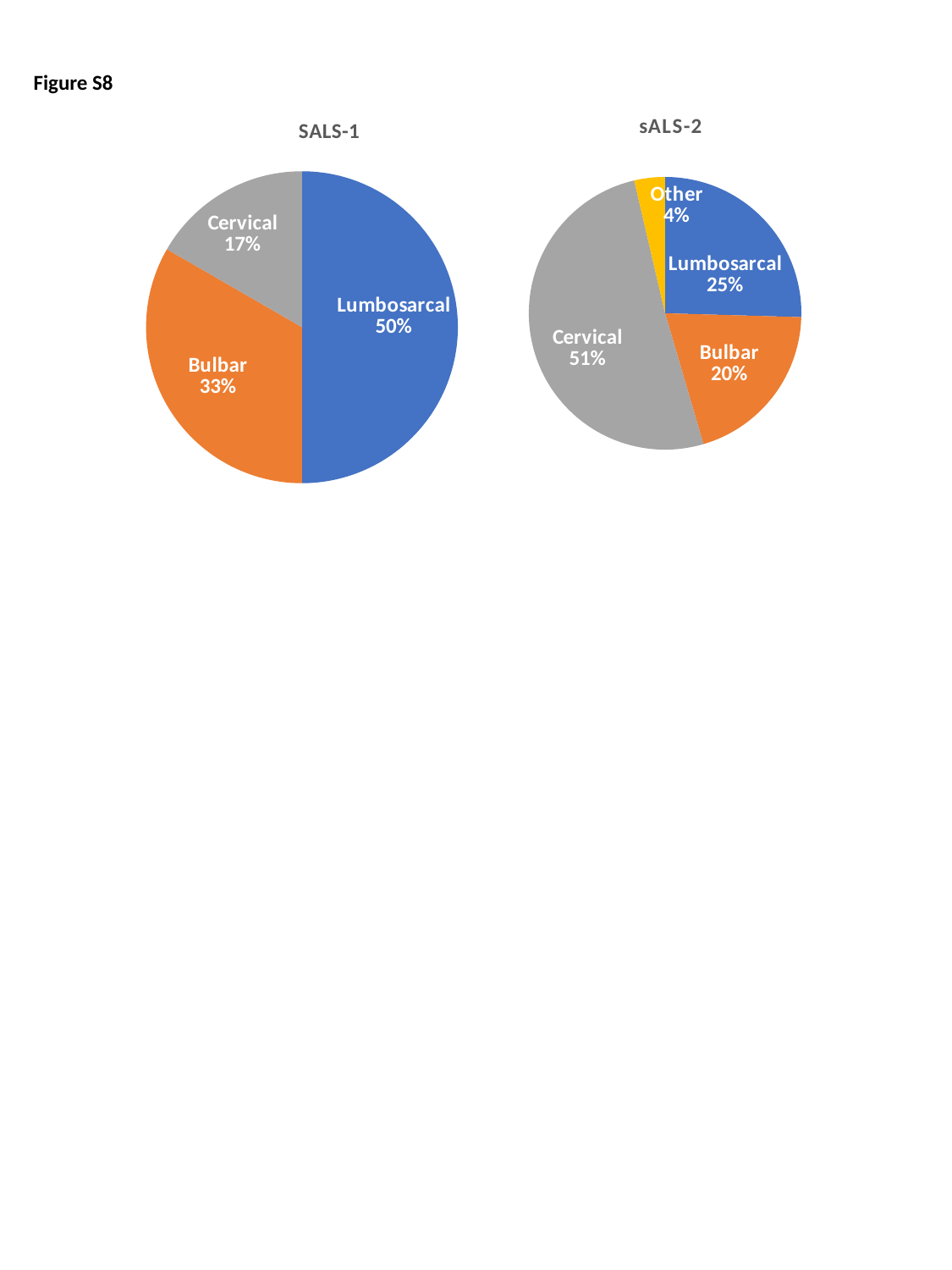
In the sALS-2 chart, which is larger, Lumbosarcal or Bulbar? Lumbosarcal In the SALS-1 chart, what percentage is shown for Bulbar? 33% How many slices does the SALS-1 chart have? 3 What type of chart is the SALS-1 chart? Pie chart In the SALS-1 chart, what is the difference in percentage points between Bulbar and Cervical? 16 In the sALS-2 chart, what is the difference in percentage points between Cervical and Lumbosarcal? 26 How many slices does the sALS-2 chart have? 4 In the sALS-2 chart, what percentage is shown for Other? 4% In the sALS-2 chart, what percentage is shown for Cervical? 51% In the sALS-2 chart, which category has the smallest share? Other In the SALS-1 chart, what percentage is shown for Lumbosarcal? 50% In the SALS-1 chart, which category has the largest share? Lumbosarcal